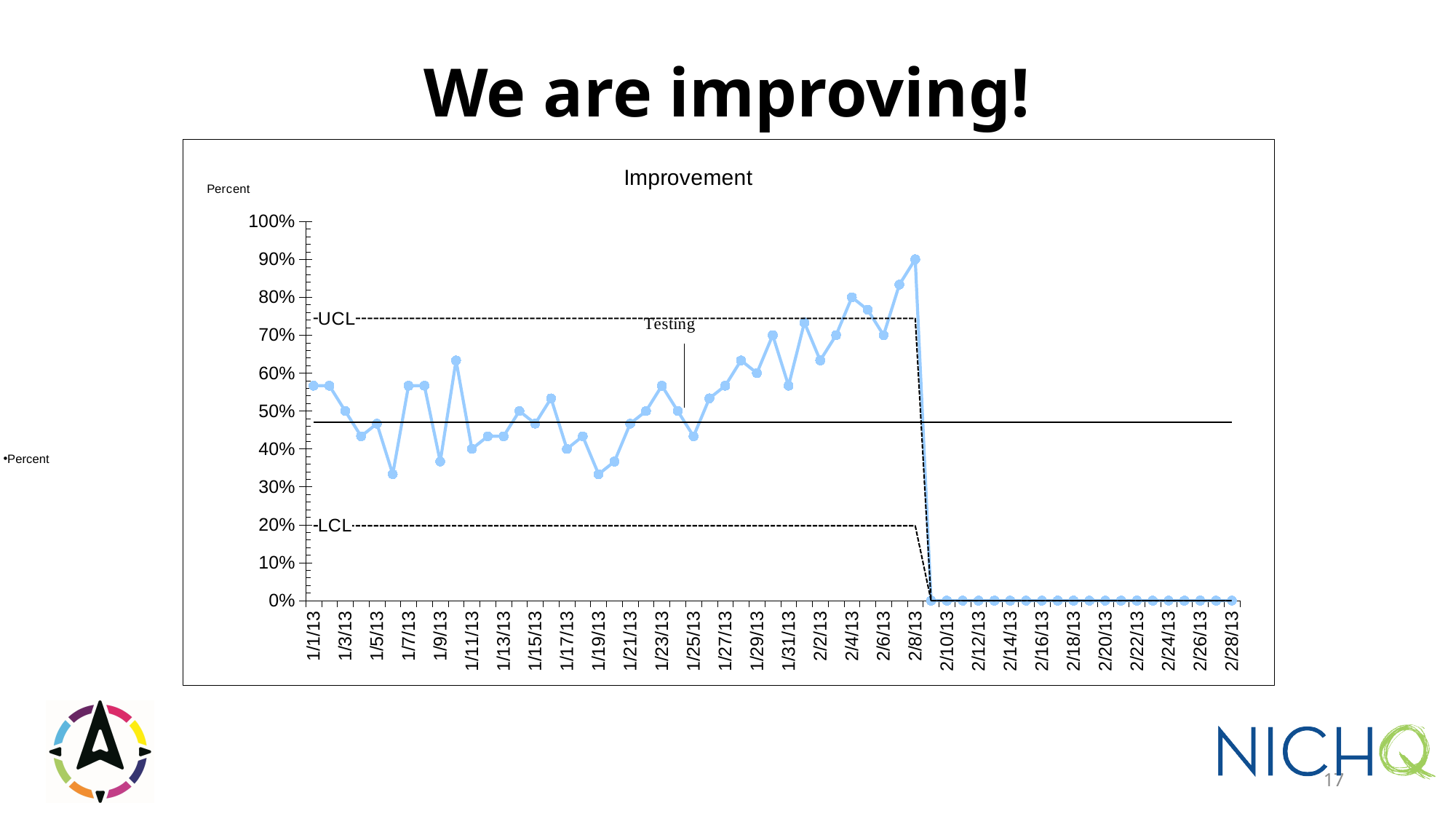
Is the value for 2/8/13 greater or less than 80%? greater What is the value plotted for 2/20/13? 0% Is the value for 1/19/13 greater or less than 40%? less Is the value for 1/6/13 greater or less than 40%? less Which date has the larger value, 1/6/13 or 1/7/13? 1/7/13 Between 1/25/13 and 2/8/13, do the plotted values generally rise or fall? rise What is the title of the chart? Improvement On which date does the plotted line reach its highest value? 2/8/13 What label is shown on the vertical axis of the chart? Percent What kind of chart is shown on the slide? line chart Which date has the larger value, 1/1/13 or 2/8/13? 2/8/13